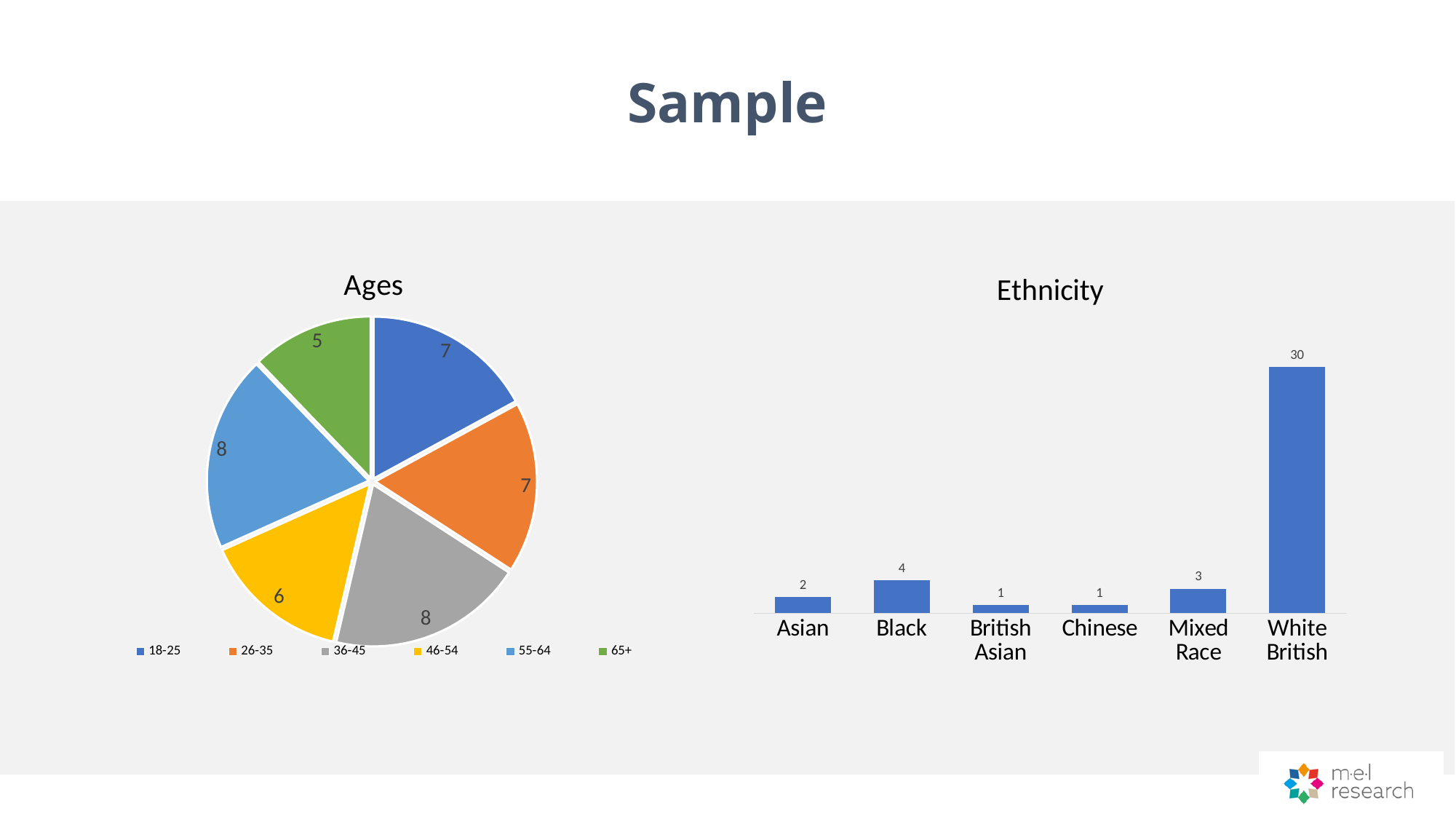
What kind of chart is the Ethnicity chart? Bar chart In the Ages pie chart, what colour is the 36-45 slice? Grey In the Ethnicity chart, which is larger, the value for Black or the value for Mixed Race? Black In the Ages pie chart, what is the total of all slices? 41 In the Ages pie chart, how many age groups does the legend list? 6 In the Ages pie chart, which age group has the smallest slice? 65+ In the Ethnicity chart, which category has the highest value? White British In the Ethnicity chart, what is the difference between the values for Black and Asian? 2 In the Ages pie chart, what is the value for the 65+ slice? 5 In the Ethnicity chart, what is the value for White British? 30 In the Ethnicity chart, what is the value for Mixed Race? 3 In the Ages pie chart, what is the value for the 46-54 slice? 6